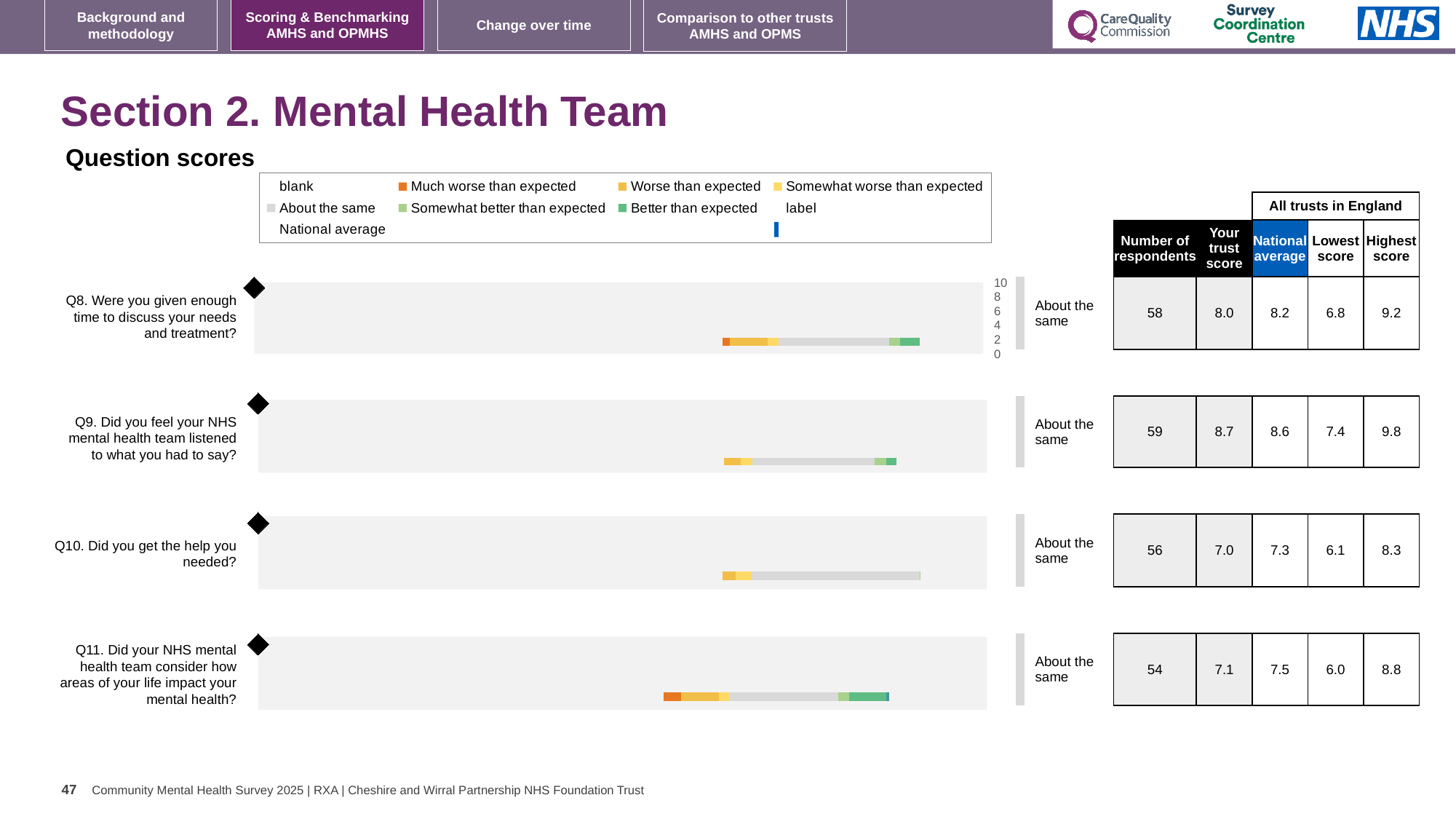
How many questions are charted on this slide? 4 Which question has the lowest 'Your trust score' on this slide? Q10 What benchmark category is shown next to the chart for Q10? About the same What is the 'Your trust score' value for Q8 (Were you given enough time to discuss your needs and treatment)? 8.0 For Q11, which is larger: the trust score or the national average? National average Which question has the highest 'Your trust score' on this slide? Q9 What is the highest score among all trusts in England for Q11 (Did your NHS mental health team consider how areas of your life impact your mental health)? 8.8 For Q11, what is the difference between the highest score and the lowest score among all trusts in England? 2.8 What is the national average score for Q10 (Did you get the help you needed)? 7.3 What is the lowest score among all trusts in England for Q9? 7.4 How many respondents are listed for Q9 (Did you feel your NHS mental health team listened to what you had to say)? 59 For Q8, what is the difference between the national average and the trust score? 0.2